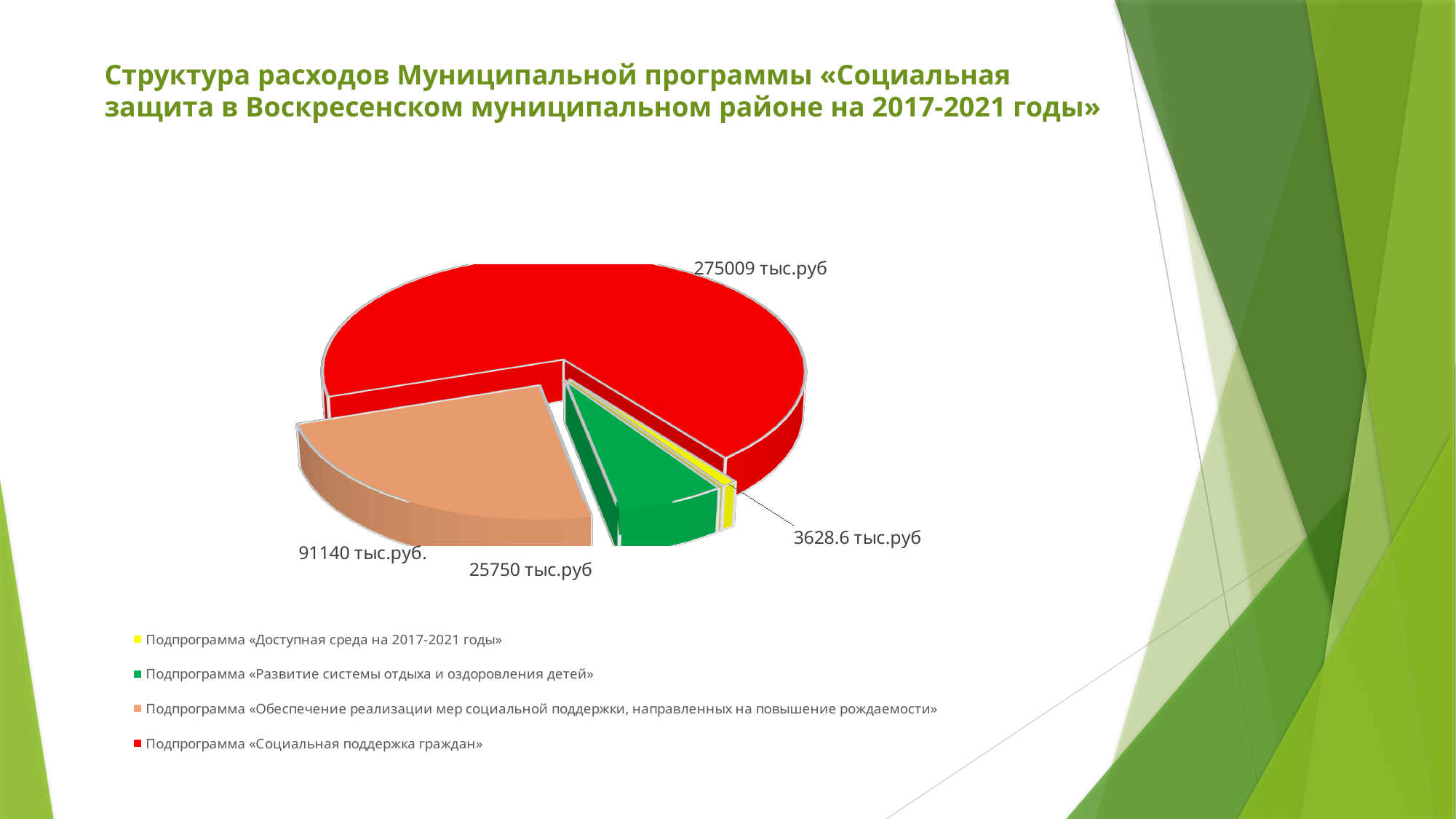
What value is shown for the slice «Развитие системы отдыха и оздоровления детей»? 25750 тыс.руб Which subprogram has the largest share of expenditure in the pie chart? Подпрограмма «Социальная поддержка граждан» Which subprogram has the smallest share of expenditure in the pie chart? Подпрограмма «Доступная среда на 2017-2021 годы» What value is shown for the slice «Доступная среда на 2017-2021 годы»? 3628.6 тыс.руб What is the total of all four values shown on the pie chart? 395527.6 тыс.руб What type of chart is shown on the slide? Pie chart Which is larger: the value for «Развитие системы отдыха и оздоровления детей» or for «Доступная среда на 2017-2021 годы»? Развитие системы отдыха и оздоровления детей How many slices does the pie chart have? 4 What value is shown for the slice «Социальная поддержка граждан»? 275009 тыс.руб What is the difference between the values for «Социальная поддержка граждан» and «Обеспечение реализации мер социальной поддержки, направленных на повышение рождаемости»? 183869 тыс.руб Which colour represents «Развитие системы отдыха и оздоровления детей» in the pie chart? Green What value is shown for the slice «Обеспечение реализации мер социальной поддержки, направленных на повышение рождаемости»? 91140 тыс.руб.